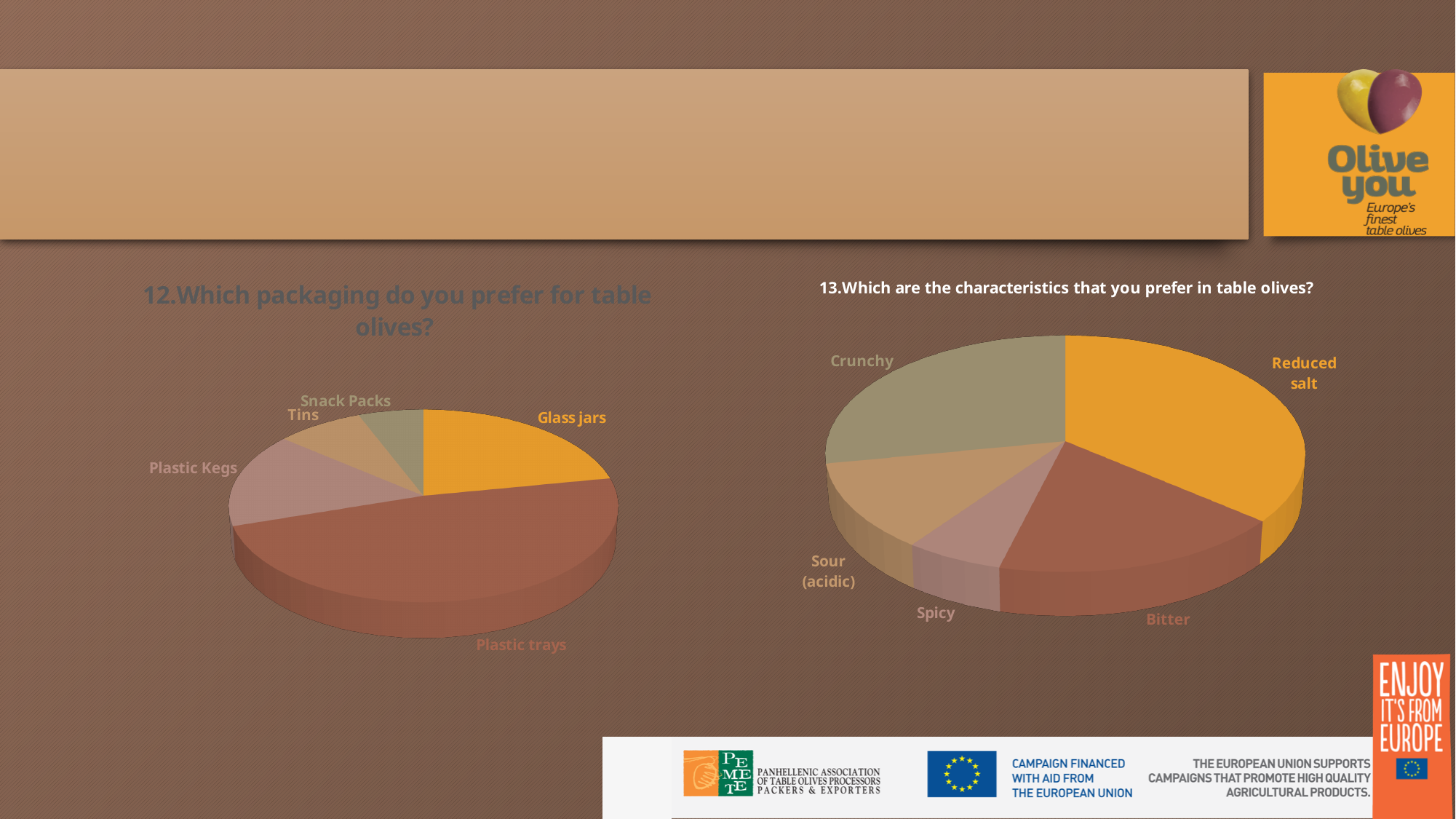
In the '13.Which are the characteristics that you prefer in table olives?' chart, which characteristic has the smallest slice? Spicy In the '13.Which are the characteristics that you prefer in table olives?' chart, which characteristic has the largest slice? Reduced salt What kind of chart is used for '12.Which packaging do you prefer for table olives?'? Pie chart What is the title of the pie chart on the left of the slide? 12.Which packaging do you prefer for table olives? In the '12.Which packaging do you prefer for table olives?' chart, which slice is larger, Plastic trays or Plastic Kegs? Plastic trays What is the title of the pie chart on the right of the slide? 13.Which are the characteristics that you prefer in table olives? How many categories are shown in the '13.Which are the characteristics that you prefer in table olives?' pie chart? 5 How many categories are shown in the '12.Which packaging do you prefer for table olives?' pie chart? 5 What kind of chart is used for '13.Which are the characteristics that you prefer in table olives?'? Pie chart In the '12.Which packaging do you prefer for table olives?' chart, which slice is larger, Glass jars or Tins? Glass jars In the '12.Which packaging do you prefer for table olives?' chart, which packaging has the largest slice? Plastic trays In the '13.Which are the characteristics that you prefer in table olives?' chart, which slice is larger, Bitter or Spicy? Bitter